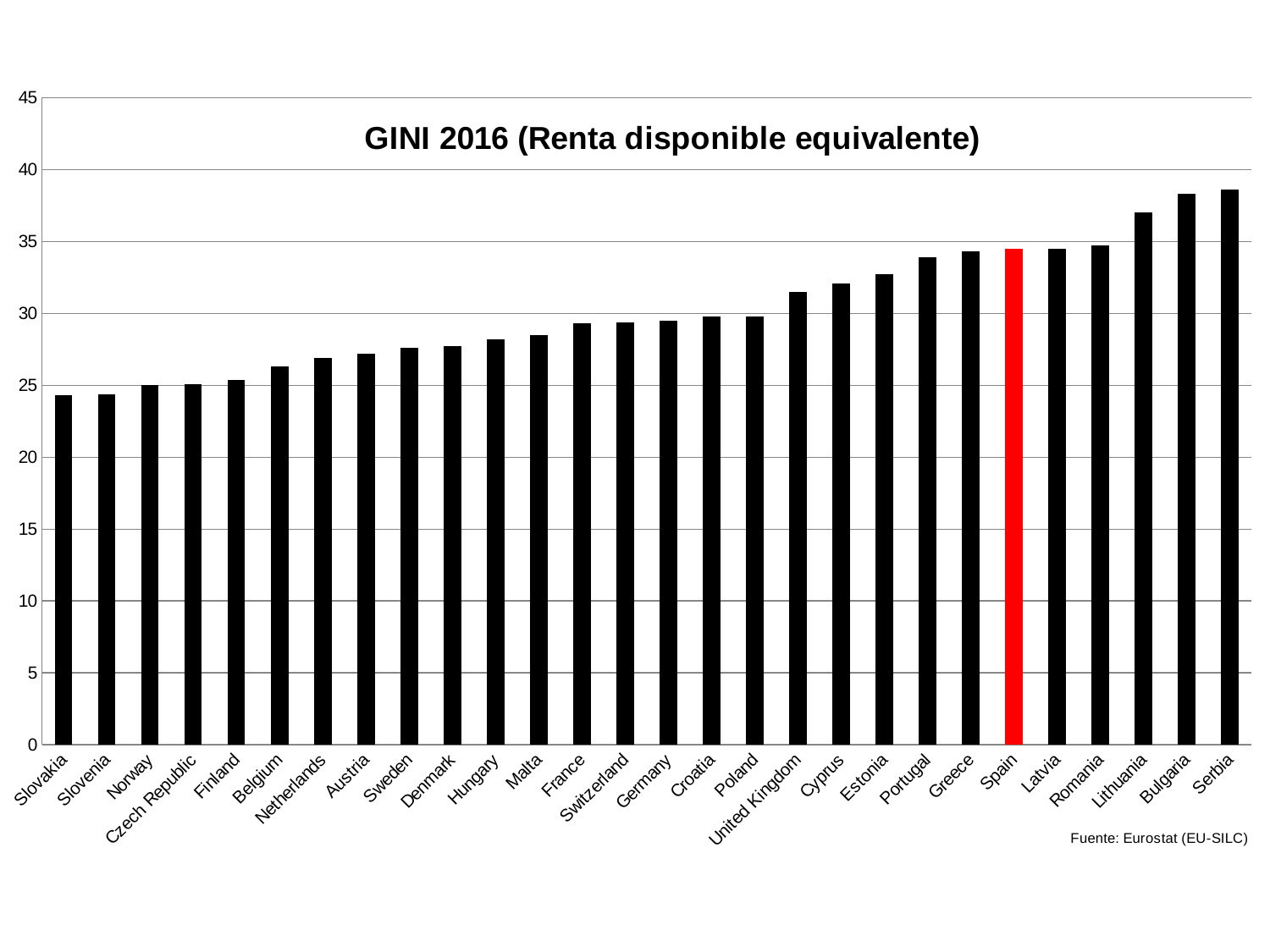
Which has the larger value, Serbia or Slovakia? Serbia What is the title of the chart? GINI 2016 (Renta disponible equivalente) How many countries are shown on the x axis of the chart? 28 Which has the larger value, Spain or Germany? Spain Is the value for Serbia greater or less than 35? greater Which country's bar is coloured red? Spain Is the value for United Kingdom greater or less than 30? greater Is the value for Finland greater or less than 30? less What kind of chart is shown on the slide? bar chart Do the values rise or fall from left to right along the x axis? rise